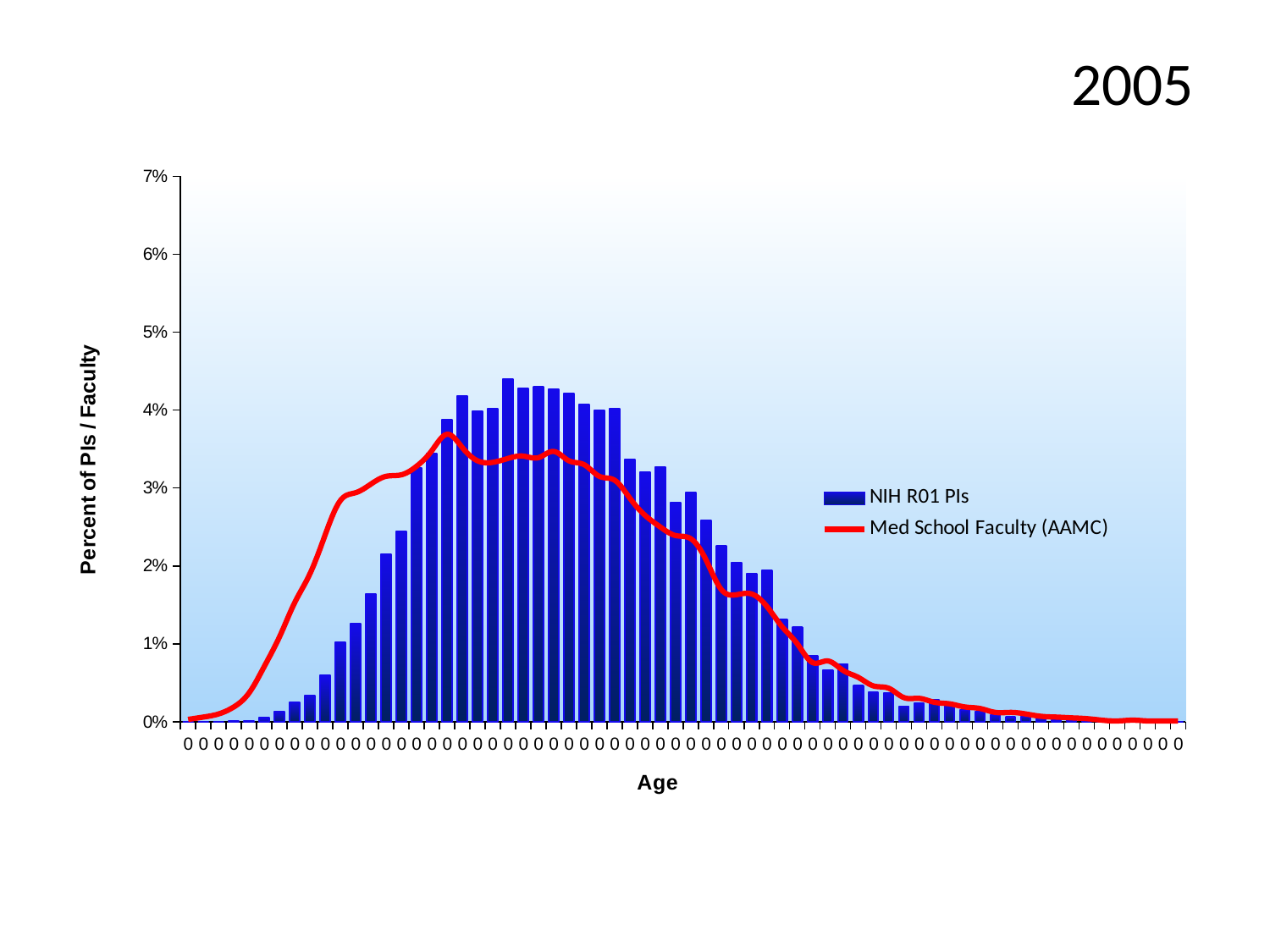
Is the highest value of the NIH R01 PIs bars greater or less than 5%? less Is the highest value of the NIH R01 PIs bars greater or less than 4%? greater Is the peak of the Med School Faculty (AAMC) line greater or less than 4%? less What kind of chart is shown on the slide? A combined bar and line chart What is the label on the vertical axis? Percent of PIs / Faculty What are the two series named in the legend? NIH R01 PIs and Med School Faculty (AAMC) How many series does the legend list? 2